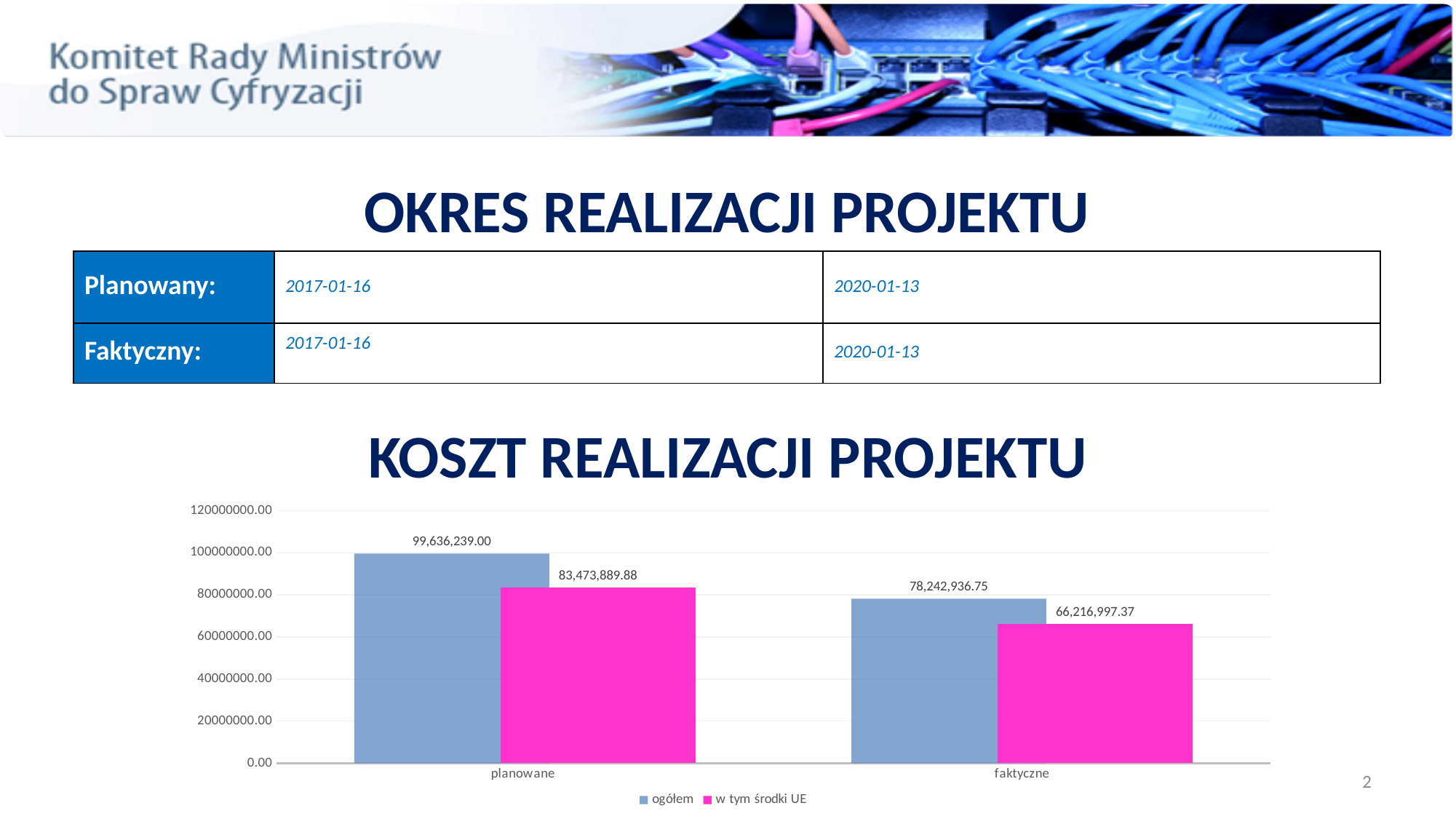
In the KOSZT REALIZACJI PROJEKTU chart, what is the difference between ogółem and w tym środki UE for faktyczne? 12,025,939.38 In the KOSZT REALIZACJI PROJEKTU chart, what is the difference between the ogółem values for planowane and faktyczne? 21,393,302.25 In the KOSZT REALIZACJI PROJEKTU chart, what is the value of ogółem for planowane? 99,636,239.00 In the KOSZT REALIZACJI PROJEKTU chart, what is the value of w tym środki UE for planowane? 83,473,889.88 In the KOSZT REALIZACJI PROJEKTU chart, what is the value of ogółem for faktyczne? 78,242,936.75 What type of chart is shown under the title KOSZT REALIZACJI PROJEKTU? bar chart In the KOSZT REALIZACJI PROJEKTU chart, is the w tym środki UE value for planowane larger or smaller than the ogółem value for faktyczne? larger In the KOSZT REALIZACJI PROJEKTU chart, what is the value of w tym środki UE for faktyczne? 66,216,997.37 How many categories are shown on the x axis of the KOSZT REALIZACJI PROJEKTU chart? 2 In the KOSZT REALIZACJI PROJEKTU chart, which category has the highest ogółem value? planowane In the KOSZT REALIZACJI PROJEKTU chart, which bar has the lowest value overall? w tym środki UE for faktyczne How many series does the legend of the KOSZT REALIZACJI PROJEKTU chart list? 2